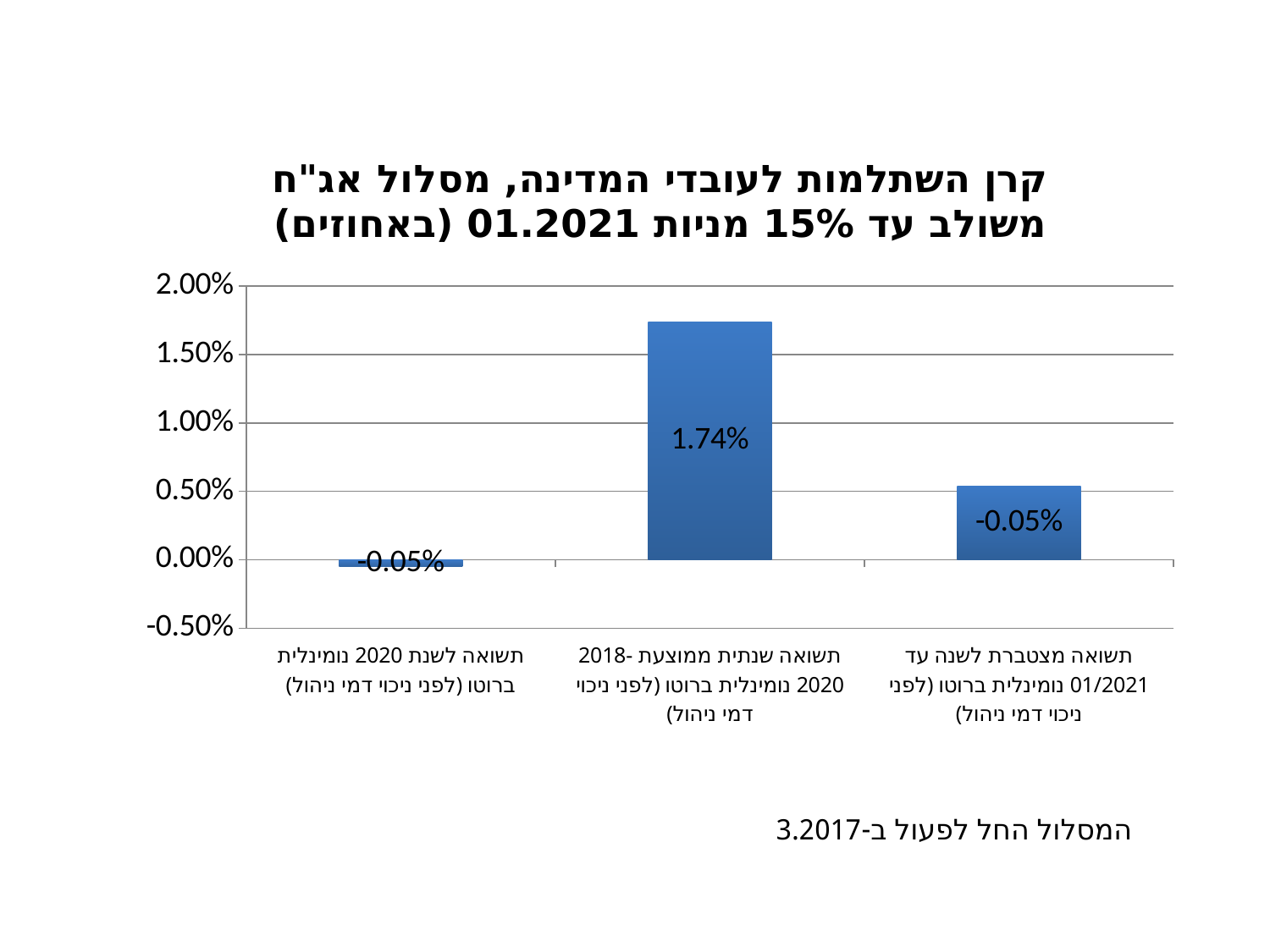
What is the lowest value shown on the y axis of the chart? -0.50% How many categories (bars) are shown in the chart? 3 What is the title of the chart? קרן השתלמות לעובדי המדינה, מסלול אג"ח משולב עד 15% מניות 01.2021 (באחוזים) Is the value for 'תשואה לשנת 2020 נומינלית ברוטו' greater or less than 0.50%? less Which is larger: the value for 'תשואה לשנת 2020' or the value for 'תשואה שנתית ממוצעת 2018-2020'? תשואה שנתית ממוצעת 2018-2020 What is the value for 'תשואה לשנת 2020 נומינלית ברוטו (לפני ניכוי דמי ניהול)'? -0.05% What is the value for 'תשואה שנתית ממוצעת 2018-2020 נומינלית ברוטו (לפני ניכוי דמי ניהול)'? 1.74% Is the value for 'תשואה שנתית ממוצעת 2018-2020' greater or less than 1.50%? greater What is the difference between the value for 'תשואה שנתית ממוצעת 2018-2020' (1.74%) and the value for 'תשואה לשנת 2020' (-0.05%)? 1.79% Which category has the highest value in the chart? תשואה שנתית ממוצעת 2018-2020 נומינלית ברוטו (לפני ניכוי דמי ניהול) What kind of chart is shown on the slide? bar chart